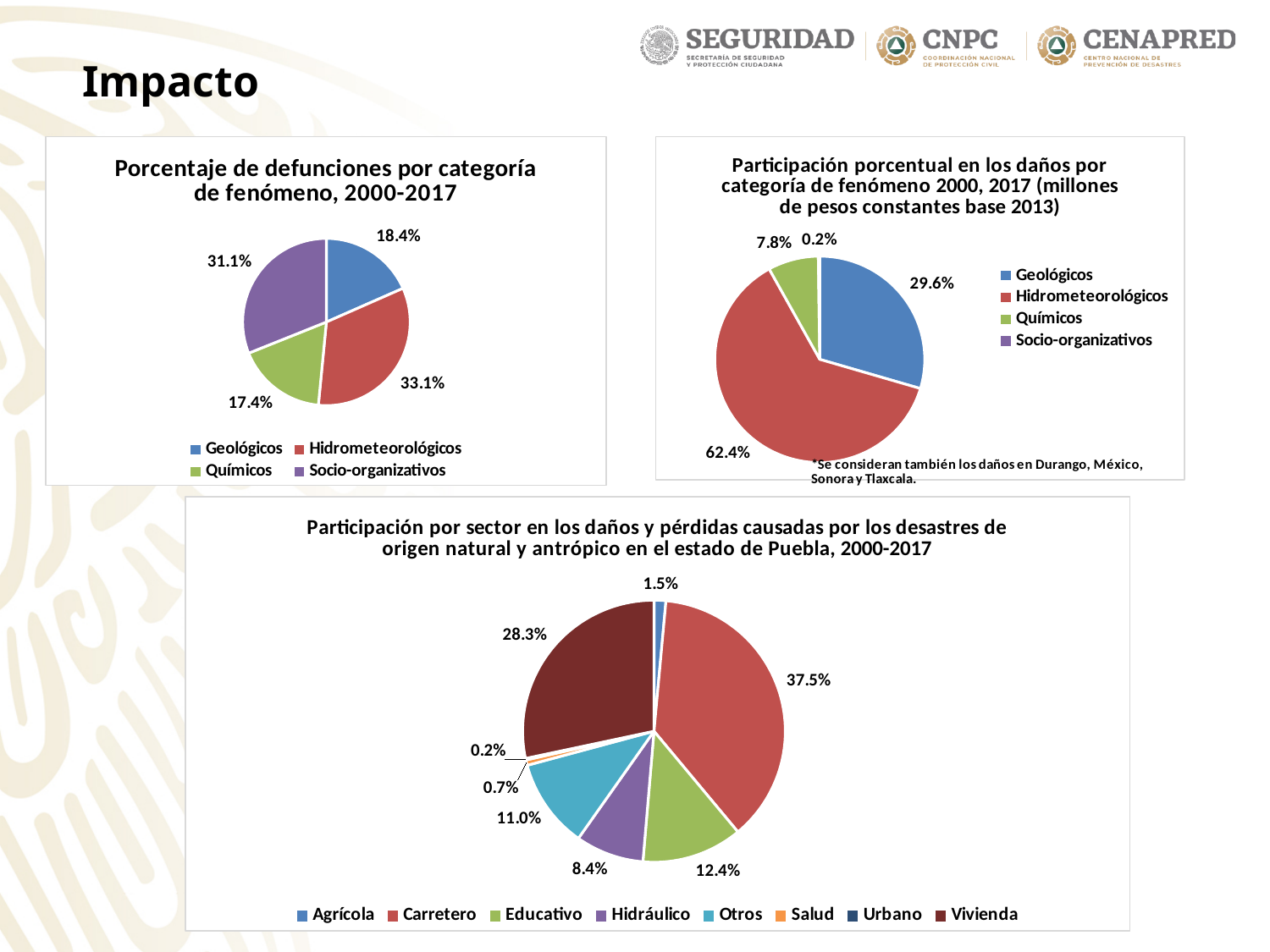
In the chart 'Porcentaje de defunciones por categoría de fenómeno, 2000-2017', what is the difference between the Socio-organizativos and Geológicos shares? 12.7% In the chart 'Porcentaje de defunciones por categoría de fenómeno, 2000-2017', what percentage corresponds to Hidrometeorológicos? 33.1% In the chart 'Participación porcentual en los daños por categoría de fenómeno 2000, 2017', which is larger, Geológicos or Químicos? Geológicos In the chart 'Participación por sector en los daños y pérdidas... estado de Puebla, 2000-2017', what is the share for Carretero? 37.5% In the chart 'Participación por sector en los daños y pérdidas... estado de Puebla, 2000-2017', which sector has the largest share? Carretero In the chart 'Participación porcentual en los daños por categoría de fenómeno 2000, 2017', which category has the smallest share? Socio-organizativos In the chart 'Participación por sector en los daños y pérdidas... estado de Puebla, 2000-2017', what is the difference between the Vivienda and Educativo shares? 15.9% What type of chart is used for 'Participación por sector en los daños y pérdidas causadas por los desastres de origen natural y antrópico en el estado de Puebla, 2000-2017'? Pie chart In the chart 'Porcentaje de defunciones por categoría de fenómeno, 2000-2017', which category has the smallest share? Químicos In the chart 'Participación por sector en los daños y pérdidas... estado de Puebla, 2000-2017', how many sectors does the legend list? 8 In the chart 'Participación porcentual en los daños por categoría de fenómeno 2000, 2017', what percentage corresponds to Hidrometeorológicos? 62.4% In the chart 'Porcentaje de defunciones por categoría de fenómeno, 2000-2017', how many categories does the legend list? 4